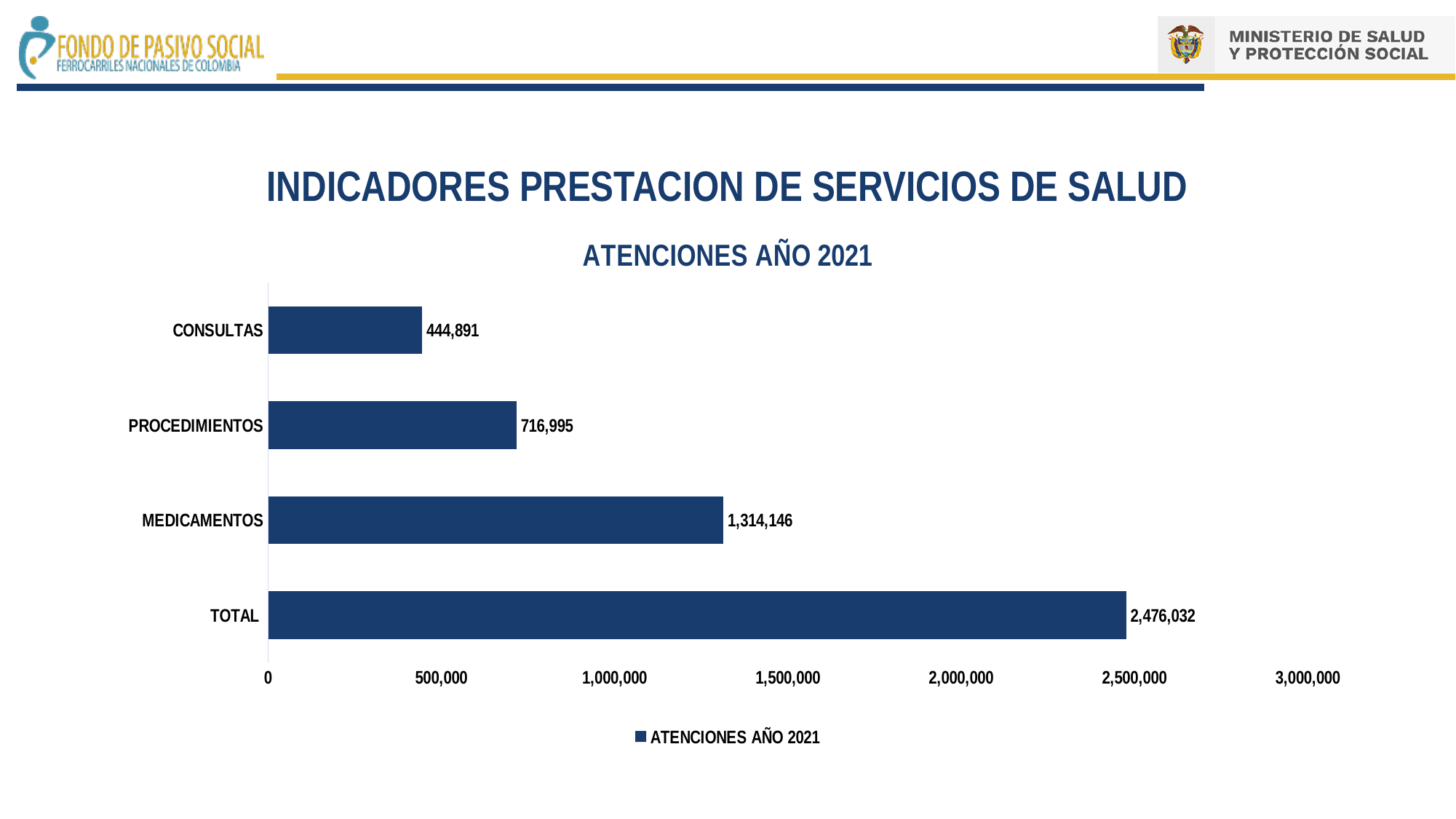
What is the value for MEDICAMENTOS? 1,314,146 What is the value for CONSULTAS in the ATENCIONES AÑO 2021 chart? 444,891 What kind of chart is shown on the slide? Bar chart What is the value for PROCEDIMIENTOS? 716,995 How many categories are shown in the chart? 4 What is the value shown for TOTAL? 2,476,032 Which is larger, MEDICAMENTOS or PROCEDIMIENTOS? MEDICAMENTOS What is the difference between MEDICAMENTOS and PROCEDIMIENTOS? 597,151 What is the difference between PROCEDIMIENTOS and CONSULTAS? 272,104 Which category has the highest value? TOTAL Which category has the lowest value? CONSULTAS What is the title of the chart? ATENCIONES AÑO 2021